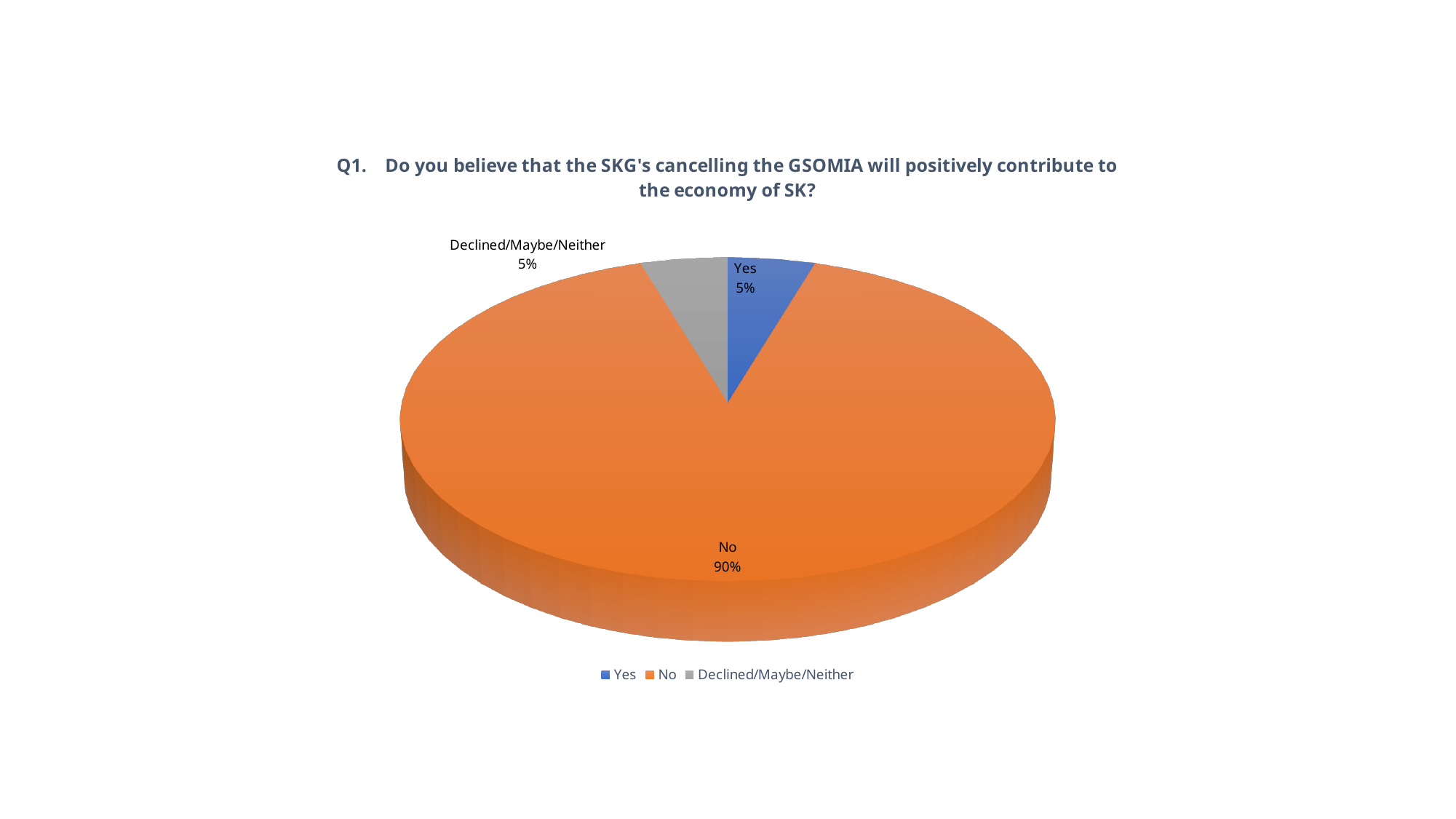
How many slices does the pie chart have? 3 What is the title of the chart? Q1. Do you believe that the SKG's cancelling the GSOMIA will positively contribute to the economy of SK? What share of respondents answered "Yes"? 5% Which response has the largest slice of the pie? No What kind of chart is shown on the slide? pie chart Which is larger, the share for "No" or the share for "Declined/Maybe/Neither"? No What share of respondents fall under "Declined/Maybe/Neither"? 5% What share of respondents answered "No"? 90% What is the difference in percentage points between the "No" share and the "Yes" share? 85 How many entries does the legend list? 3 What is the combined share of "Yes" and "Declined/Maybe/Neither"? 10% What colour is the "No" slice? orange